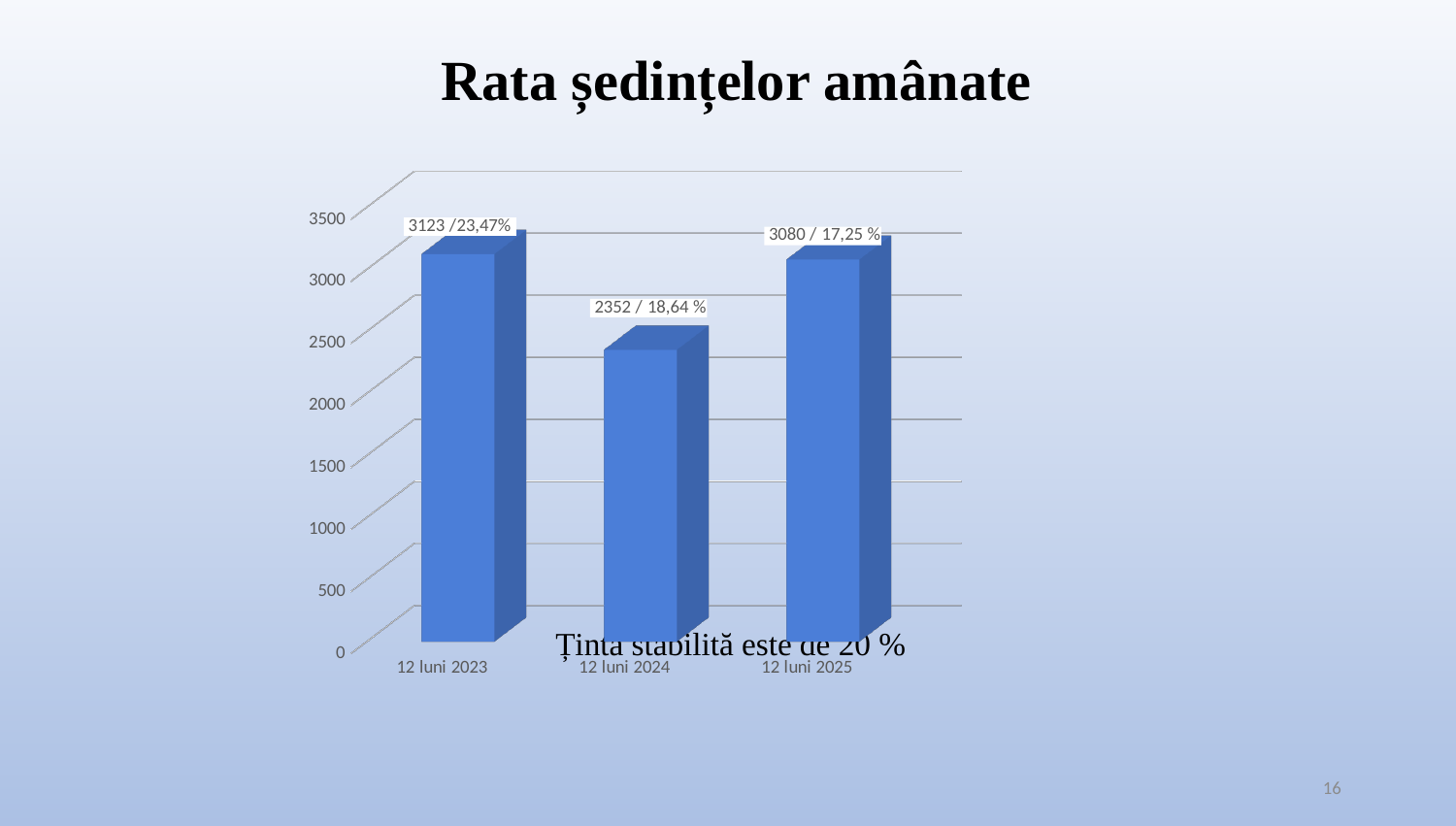
What kind of chart is shown on the slide? bar chart Which is larger, the count for 12 luni 2025 or the count for 12 luni 2024? 12 luni 2025 How many categories are shown on the x axis? 3 What is the data label shown for 12 luni 2023? 3123 /23,47% What is the data label shown for 12 luni 2025? 3080 / 17,25 % What is the data label shown for 12 luni 2024? 2352 / 18,64 % Is the value for 12 luni 2024 greater or less than 2500? less Which category has the highest bar? 12 luni 2023 What is the difference between the count for 12 luni 2023 (3123) and the count for 12 luni 2024 (2352)? 771 According to the text on the slide, what is the established target (ținta stabilită)? 20 % Which category has the lowest bar? 12 luni 2024 What is the title of the chart on the slide? Rata ședințelor amânate